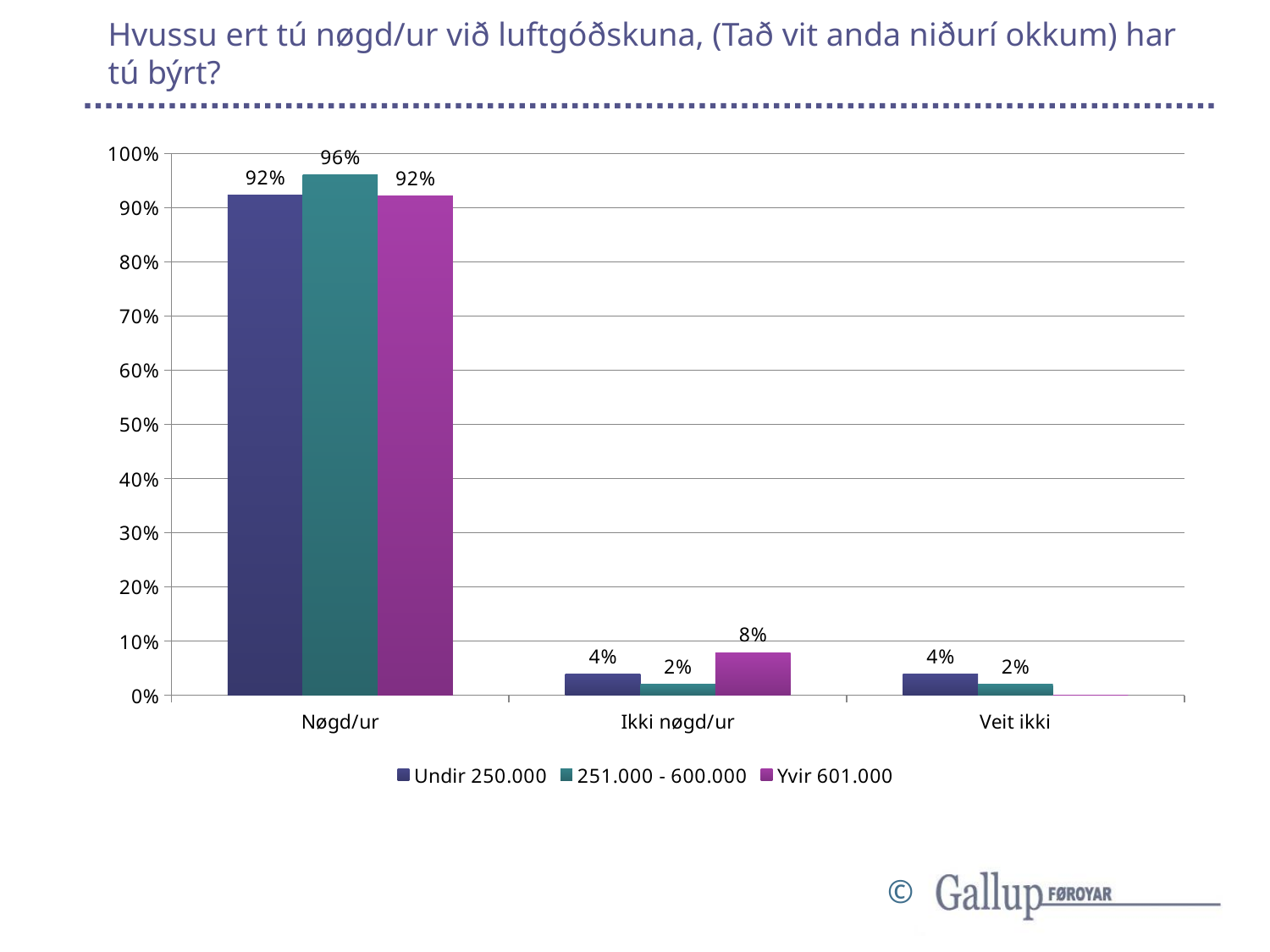
In the Ikki nøgd/ur category, which is larger: the Undir 250.000 value or the Yvir 601.000 value? Yvir 601.000 What is the difference between the 251.000 - 600.000 value and the Undir 250.000 value in the Nøgd/ur category? 4% What is the value for the Undir 250.000 series in the Veit ikki category? 4% How many categories are shown on the x axis? 3 What is the value for the Yvir 601.000 series in the Ikki nøgd/ur category? 8% Which series has the highest value in the Nøgd/ur category? 251.000 - 600.000 What is the value for the 251.000 - 600.000 series in the Nøgd/ur category? 96% Is the value for the Undir 250.000 series in the Nøgd/ur category greater or less than 90%? greater What kind of chart is shown on the slide? Bar chart What is the difference between the Yvir 601.000 value and the 251.000 - 600.000 value in the Ikki nøgd/ur category? 6% Which series has the lowest value in the Ikki nøgd/ur category? 251.000 - 600.000 How many series does the legend list? 3